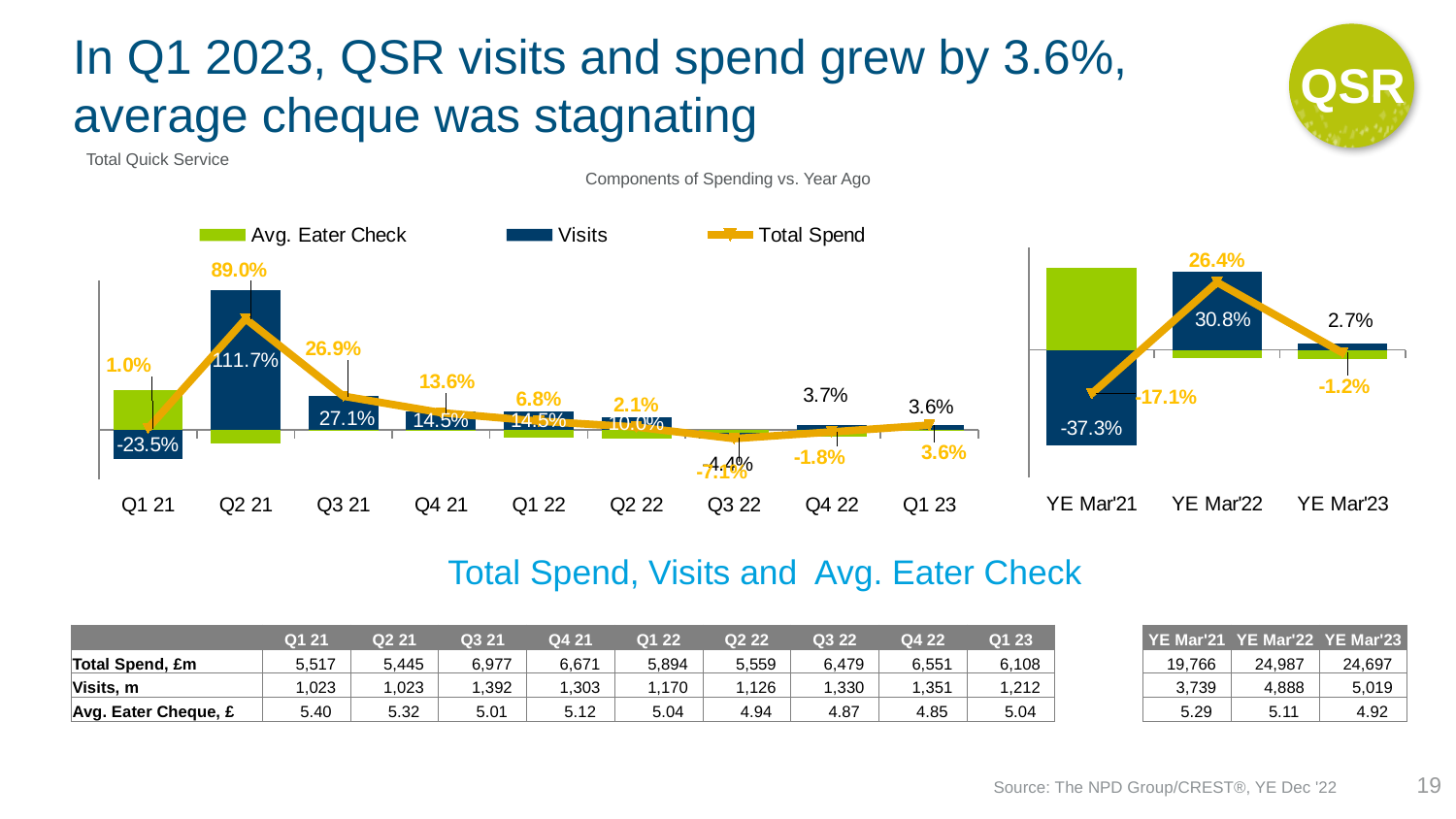
In the right chart (yearly), which period has the lowest Total Spend value? YE Mar'21 In the right chart (yearly), what is the Visits value for YE Mar'21? -37.3% In the right chart (yearly), what is the Total Spend value for YE Mar'22? 26.4% In the left chart (quarterly), which quarter has the highest Total Spend value? Q2 21 In the left chart (quarterly), what is the difference between the Total Spend values for Q2 21 and Q3 21? 62.1 percentage points In the left chart (quarterly), what is the Total Spend value for Q2 21? 89.0% In the left chart (quarterly), which is larger: the Total Spend value for Q3 21 or for Q4 21? Q3 21 In the left chart (quarterly), does the Total Spend line rise or fall from Q2 21 to Q3 22? Falls How many quarters are shown on the x axis of the left chart? 9 In the left chart (quarterly), what is the Total Spend value for Q1 23? 3.6% How many series does the legend list? 3 In the left chart (quarterly), what is the Visits value for Q1 21? -23.5%